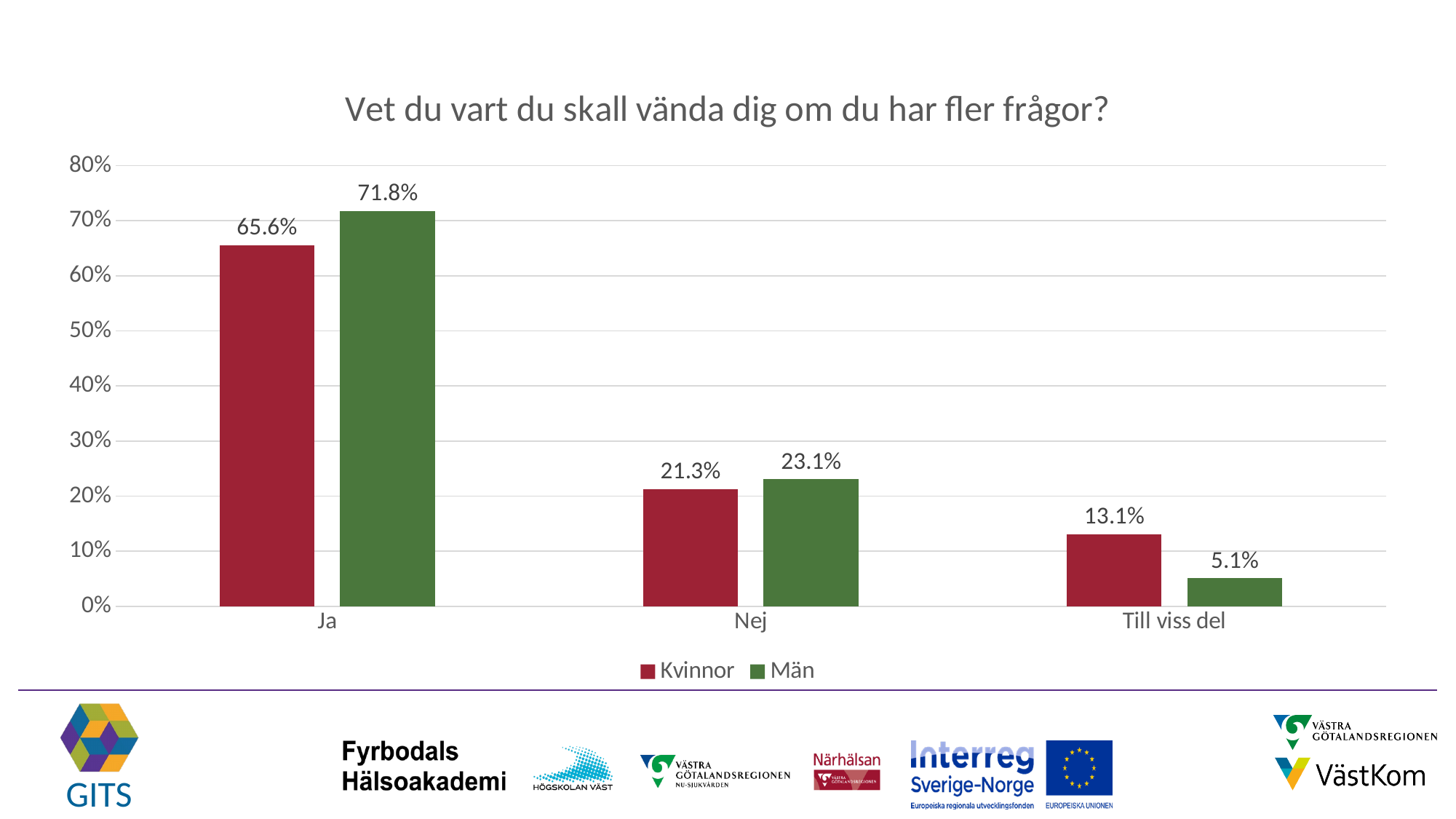
How many series does the legend list? 2 What is the title of the chart? Vet du vart du skall vända dig om du har fler frågor? Which category has the lowest value for Kvinnor? Till viss del What is the value for Män in the Till viss del category? 5.1% What kind of chart is shown on the slide? Bar chart In the Till viss del category, which series has the larger value, Kvinnor or Män? Kvinnor How many categories are shown on the x axis? 3 Which category has the highest value for Män? Ja What is the difference between the Män and Kvinnor values in the Ja category? 6.2% What is the value for Män in the Ja category? 71.8% What is the value for Kvinnor in the Nej category? 21.3% What is the value for Kvinnor in the Ja category? 65.6%